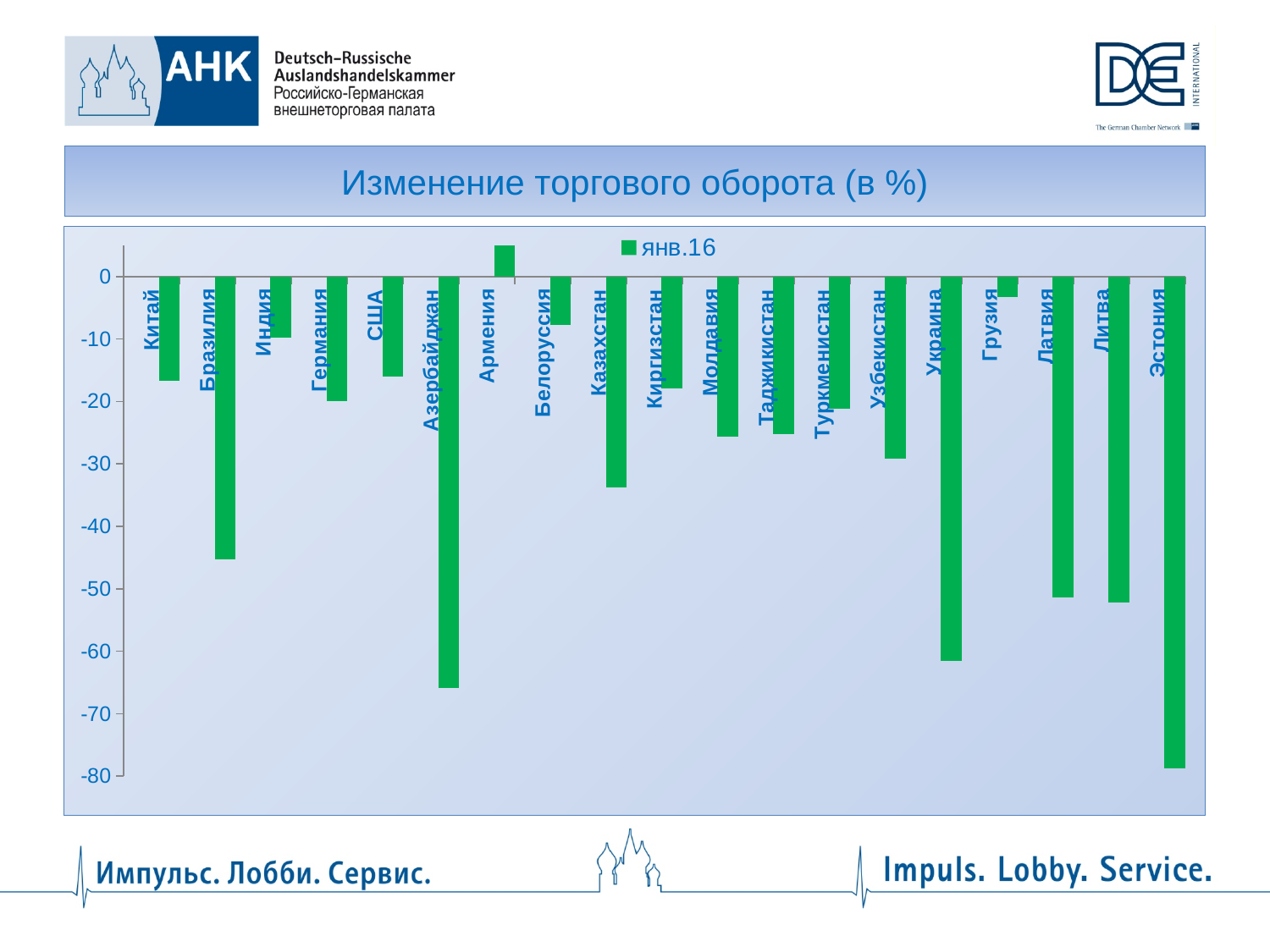
How many countries are shown on the x axis of the chart? 19 What is the title of the chart? Изменение торгового оборота (в %) Is the value for Азербайджан greater or less than -60? less Which country is the only one with a positive value? Армения Which country has the highest value in the chart? Армения Which country has the lowest value in the chart? Эстония What is the legend entry of the chart? янв.16 Which has the larger value, Китай or Украина? Китай How many series does the legend list? 1 Is the value for Бразилия greater or less than -40? less What kind of chart is shown on the slide? bar chart Is the value for Грузия greater or less than -10? greater